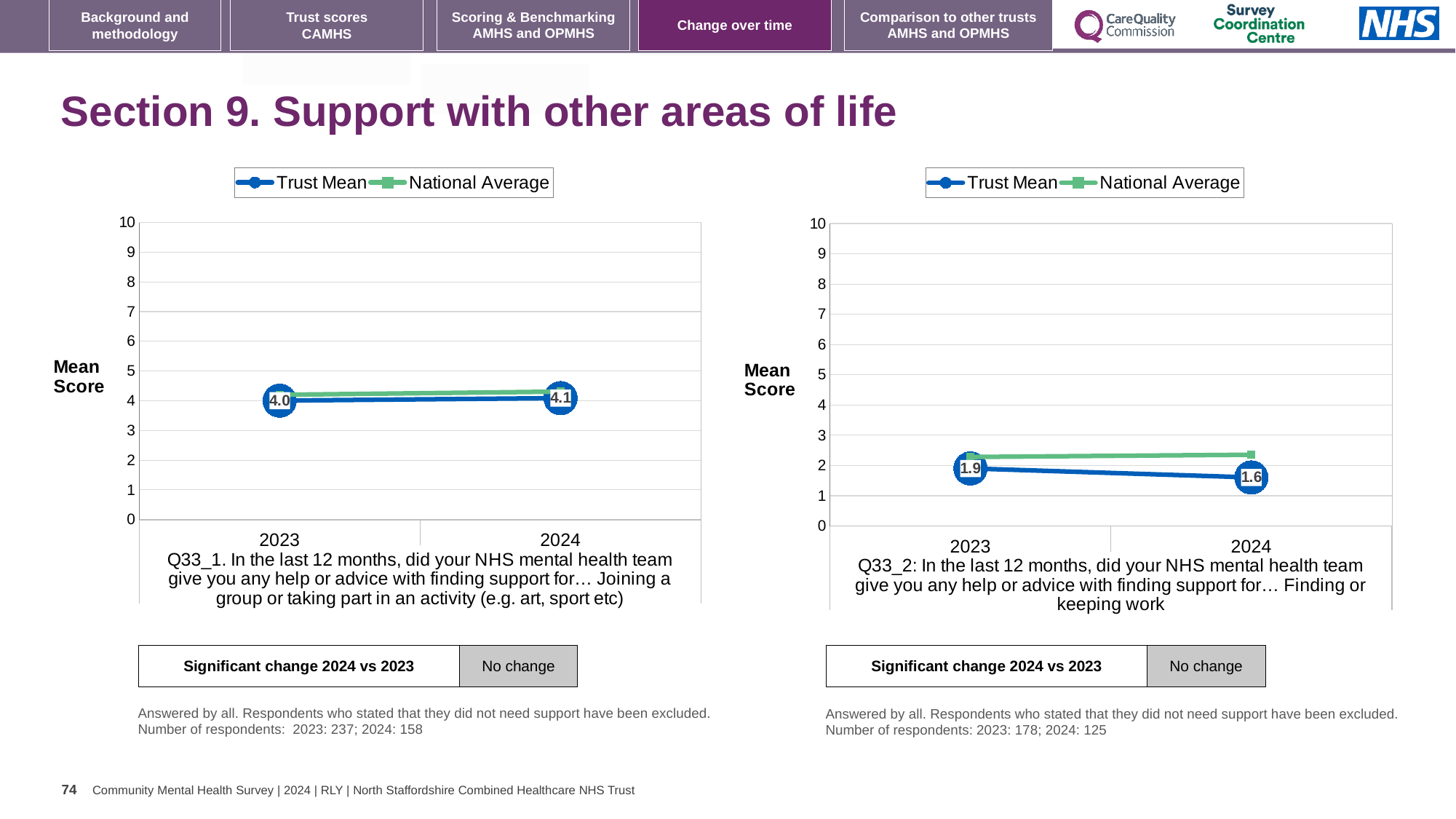
In the left chart (Q33_1), what is the Trust Mean score for 2023? 4.0 In the right chart (Q33_2), which is larger in 2024: the Trust Mean or the National Average? National Average What kind of chart is used on the left of the slide (Q33_1)? line chart In the right chart (Q33_2), by how much did the Trust Mean change from 2023 to 2024? 0.3 In the right chart (Q33_2), what is the Trust Mean score for 2023? 1.9 In the right chart (Q33_2), does the Trust Mean rise or fall from 2023 to 2024? fall In the right chart (Q33_2), is the National Average for 2024 greater or less than 3? less In the left chart (Q33_1), does the Trust Mean rise or fall from 2023 to 2024? rise In the right chart (Q33_2), what is the Trust Mean score for 2024? 1.6 How many series does the legend of the right chart (Q33_2) list? 2 In the left chart (Q33_1), what is the difference between the Trust Mean for 2024 and 2023? 0.1 In the left chart (Q33_1), what is the Trust Mean score for 2024? 4.1